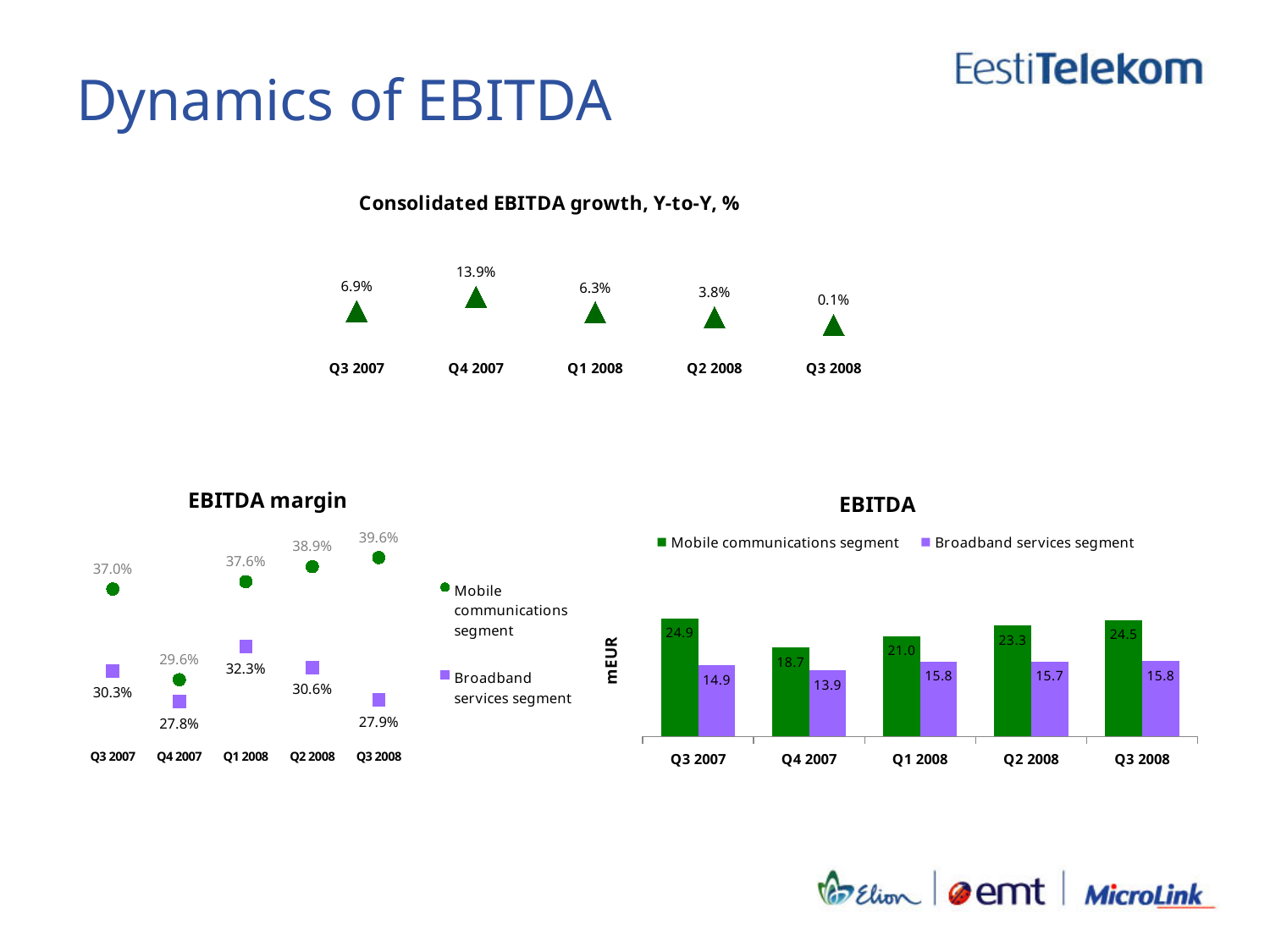
In the 'EBITDA margin' chart, what is the Broadband services segment value for Q4 2007? 27.8% In the 'Consolidated EBITDA growth, Y-to-Y, %' chart, what is the value for Q4 2007? 13.9% In the 'EBITDA' chart, which quarter has the highest Mobile communications segment value? Q3 2007 In the 'Consolidated EBITDA growth, Y-to-Y, %' chart, do the values rise or fall from Q4 2007 to Q3 2008? fall In the 'EBITDA margin' chart, how many series does the legend list? 2 In the 'EBITDA' chart, what is the difference between the Mobile communications segment and Broadband services segment values in Q3 2008? 8.7 What kind of chart is the 'EBITDA' chart? bar chart In the 'EBITDA margin' chart, what is the difference between the Mobile communications segment and Broadband services segment values in Q1 2008? 5.3% In the 'EBITDA' chart, what is the Mobile communications segment value for Q4 2007? 18.7 In the 'Consolidated EBITDA growth, Y-to-Y, %' chart, how many quarters are plotted? 5 In the 'Consolidated EBITDA growth, Y-to-Y, %' chart, which quarter has the lowest value? Q3 2008 In the 'EBITDA margin' chart, what is the Mobile communications segment value for Q3 2008? 39.6%